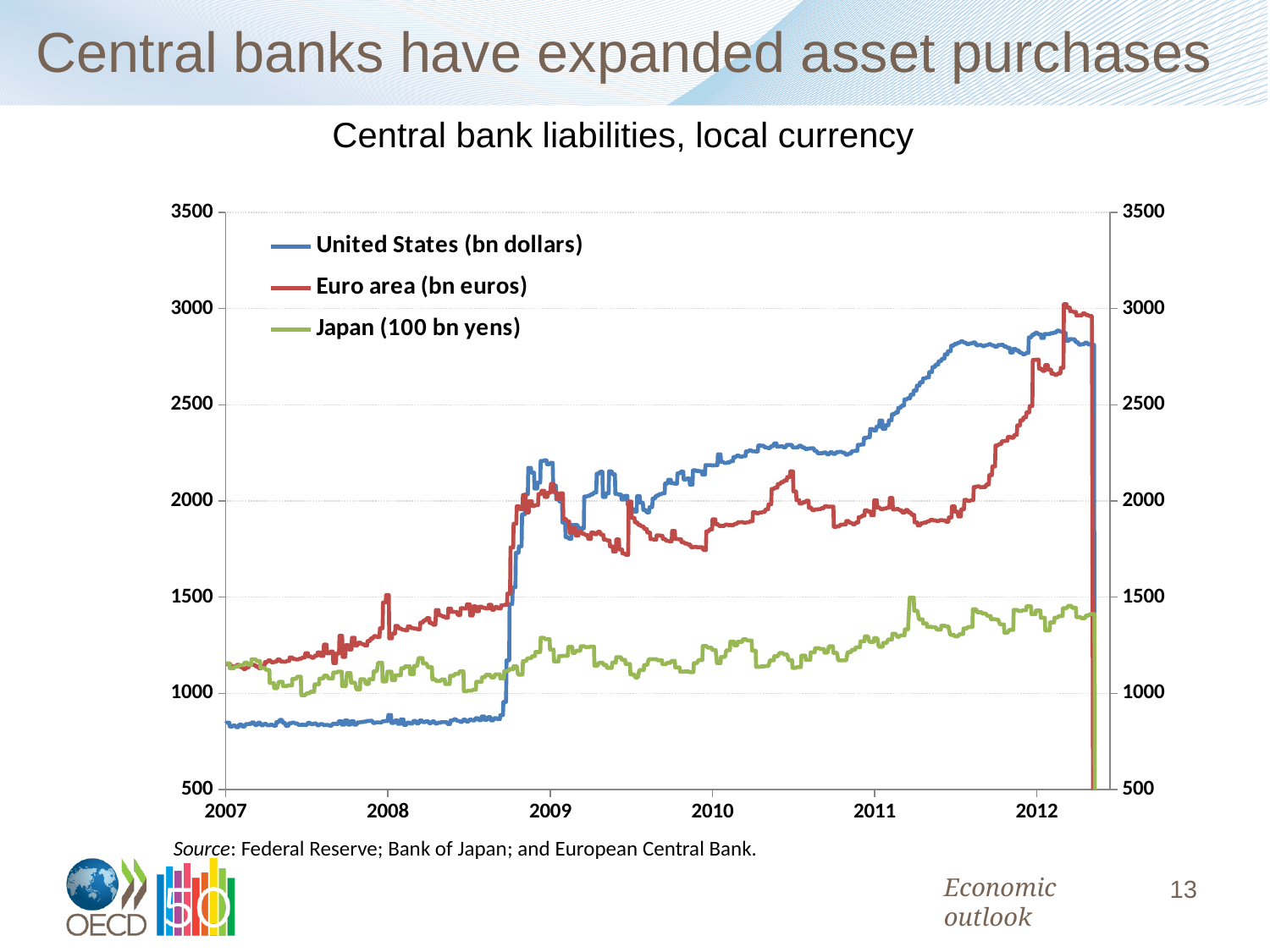
Does the United States series rise or fall overall from 2007 to 2012? rise Is the value for the United States at the start of 2007 greater or less than 1000? less How many series does the legend list? 3 At the start of 2007, which is larger: the Euro area series or the United States series? Euro area Is the value for the United States at the start of 2011 greater or less than 2000? greater At the start of 2012, which is larger: the United States series or the Japan series? United States What kind of chart is shown on the slide? line chart What are the three series listed in the legend? United States (bn dollars), Euro area (bn euros), Japan (100 bn yens) Which series has the lowest value at the start of 2007? United States What is the title of the chart? Central bank liabilities, local currency Is the value for the Euro area at the start of 2012 greater or less than 2500? greater